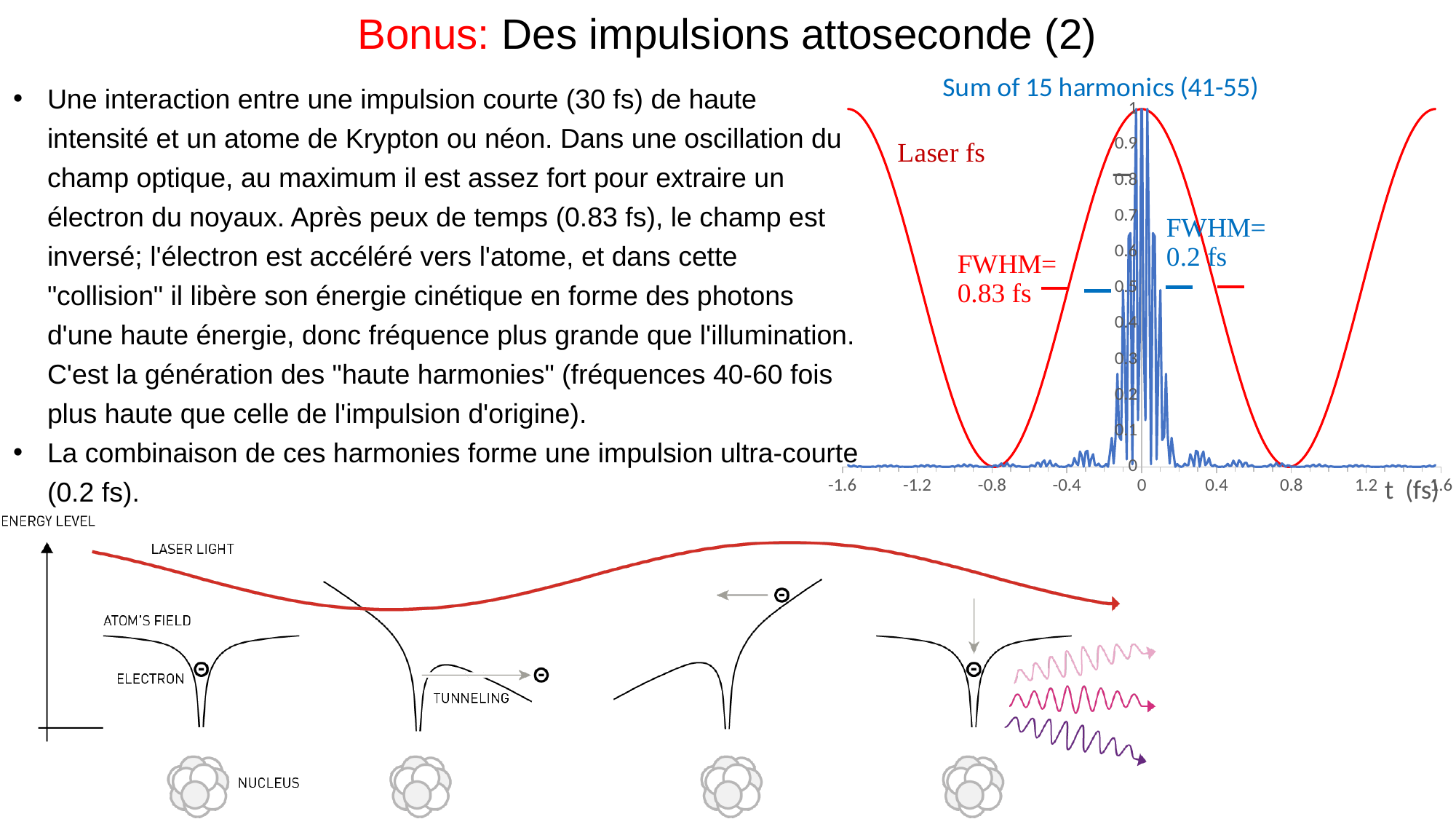
In the chart titled 'Sum of 15 harmonics (41-55)', is the value of the red 'Laser fs' curve at t = -0.8 greater or less than 0.5? less What kind of chart is shown in the top right of the slide? line chart In the chart titled 'Sum of 15 harmonics (41-55)', is the value of the blue harmonic-sum curve at t = 1.2 greater or less than 0.5? less In the chart titled 'Sum of 15 harmonics (41-55)', what is the maximum value shown on the y axis? 1 In the chart titled 'Sum of 15 harmonics (41-55)', what FWHM value is annotated for the blue harmonic-sum curve? 0.2 fs In the chart titled 'Sum of 15 harmonics (41-55)', which curve has the narrower FWHM, the red 'Laser fs' curve or the blue harmonic-sum curve? the blue harmonic-sum curve In the chart titled 'Sum of 15 harmonics (41-55)', is the value of the red 'Laser fs' curve at t = 0 greater or less than 0.5? greater In the chart titled 'Sum of 15 harmonics (41-55)', what is the highest value shown on the x axis? 1.6 What is the title of the chart in the top right of the slide? Sum of 15 harmonics (41-55) In the chart titled 'Sum of 15 harmonics (41-55)', what is the label of the x axis? t (fs) In the chart titled 'Sum of 15 harmonics (41-55)', what FWHM value is annotated for the red 'Laser fs' curve? 0.83 fs In the chart titled 'Sum of 15 harmonics (41-55)', what is the lowest value shown on the x axis? -1.6